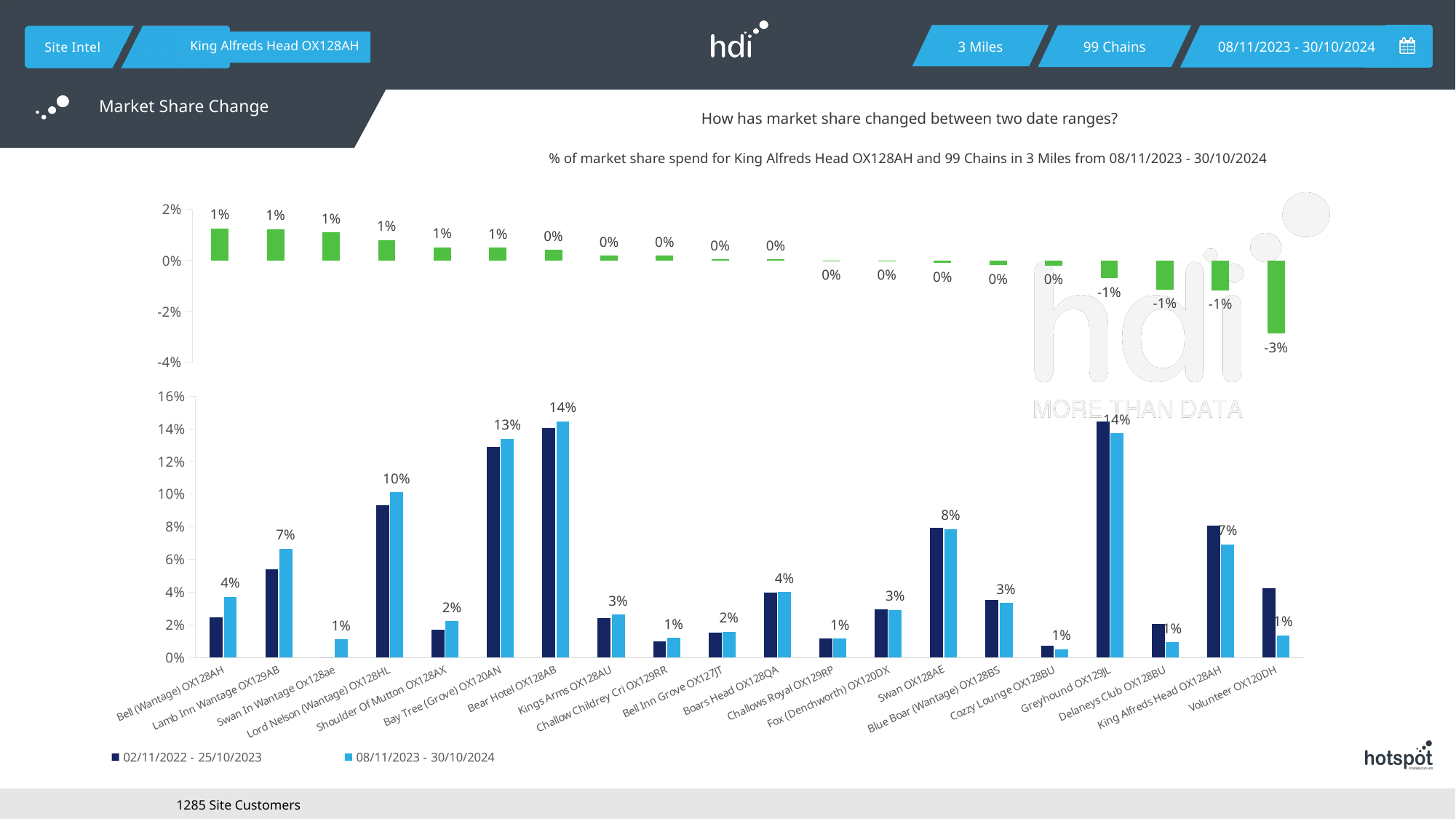
In the bottom chart, what is the market share for Lord Nelson (Wantage) OX128HL in 08/11/2023 - 30/10/2024? 10% In the top chart, what is the market share change for Bell (Wantage) OX128AH? 1% In the bottom chart, what is the difference between the 08/11/2023 - 30/10/2024 values for Lord Nelson (Wantage) OX128HL and Lamb Inn Wantage OX129AB? 3% In the bottom chart, how many series does the legend list? 2 In the bottom chart, for Greyhound OX129JL, which period has the larger market share? 02/11/2022 - 25/10/2023 In the bottom chart, what is the market share for Bear Hotel OX128AB in 08/11/2023 - 30/10/2024? 14% In the top chart, do the values rise or fall moving from left to right along the x axis? fall What kind of chart is the top chart showing market share change? bar chart In the top chart, which venue has the lowest market share change? Volunteer OX120DH How many venues (categories) are shown along the x axis of the bottom chart? 20 In the top chart, what is the market share change for Volunteer OX120DH? -3% In the bottom chart, is the 02/11/2022 - 25/10/2023 value for Lamb Inn Wantage OX129AB greater or less than 6%? less